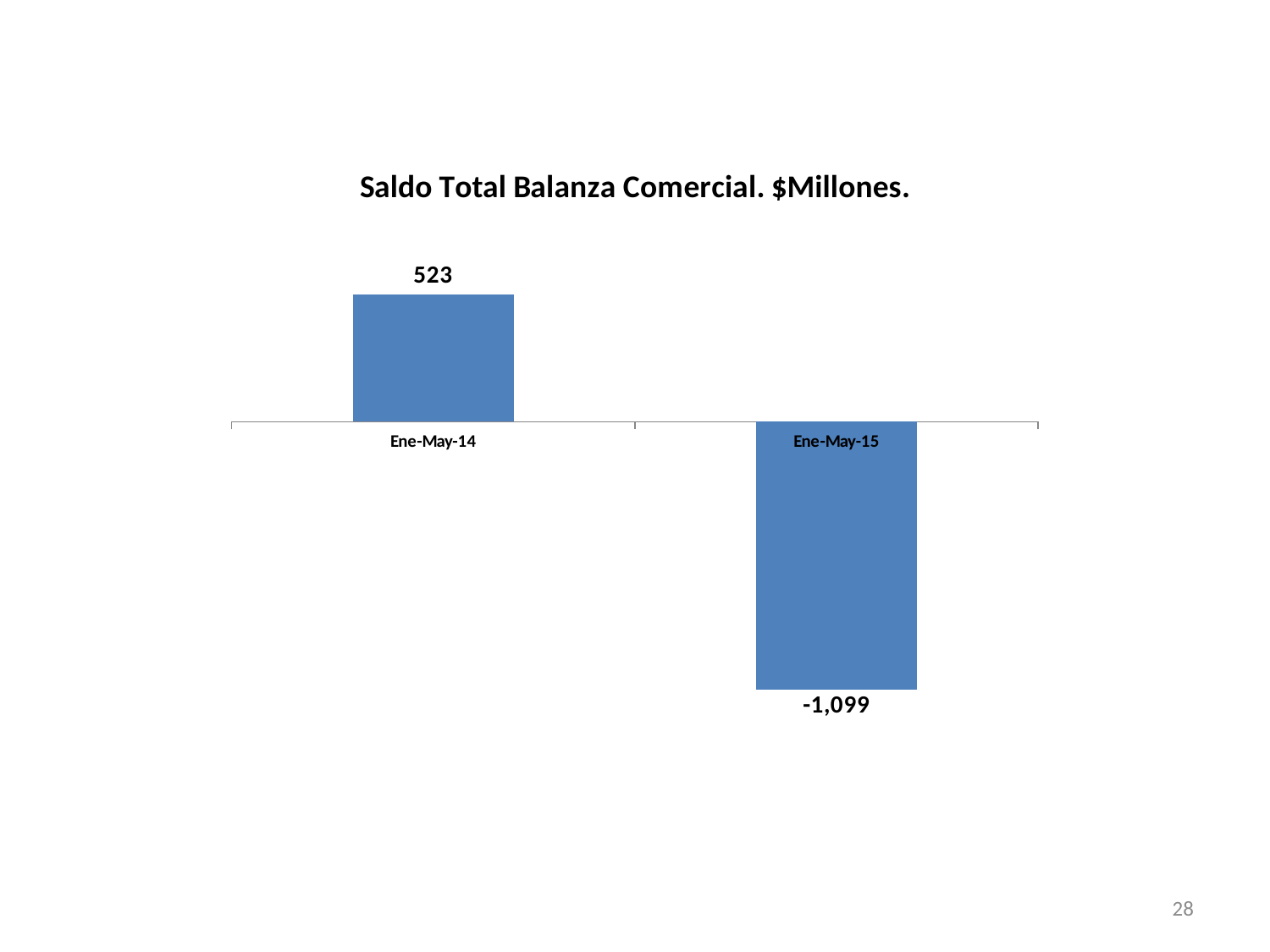
Which category has a negative value? Ene-May-15 What kind of chart is shown on the slide? Bar chart Do the values rise or fall from Ene-May-14 to Ene-May-15? Fall What is the title of the chart? Saldo Total Balanza Comercial. $Millones. Which is larger, the value for Ene-May-14 or the value for Ene-May-15? Ene-May-14 What is the value for Ene-May-14? 523 Which category has the highest value? Ene-May-14 How many categories are shown on the chart? 2 What is the value for Ene-May-15? -1,099 What is the difference between the value for Ene-May-14 and the value for Ene-May-15? 1,622 Which category has the lowest value? Ene-May-15